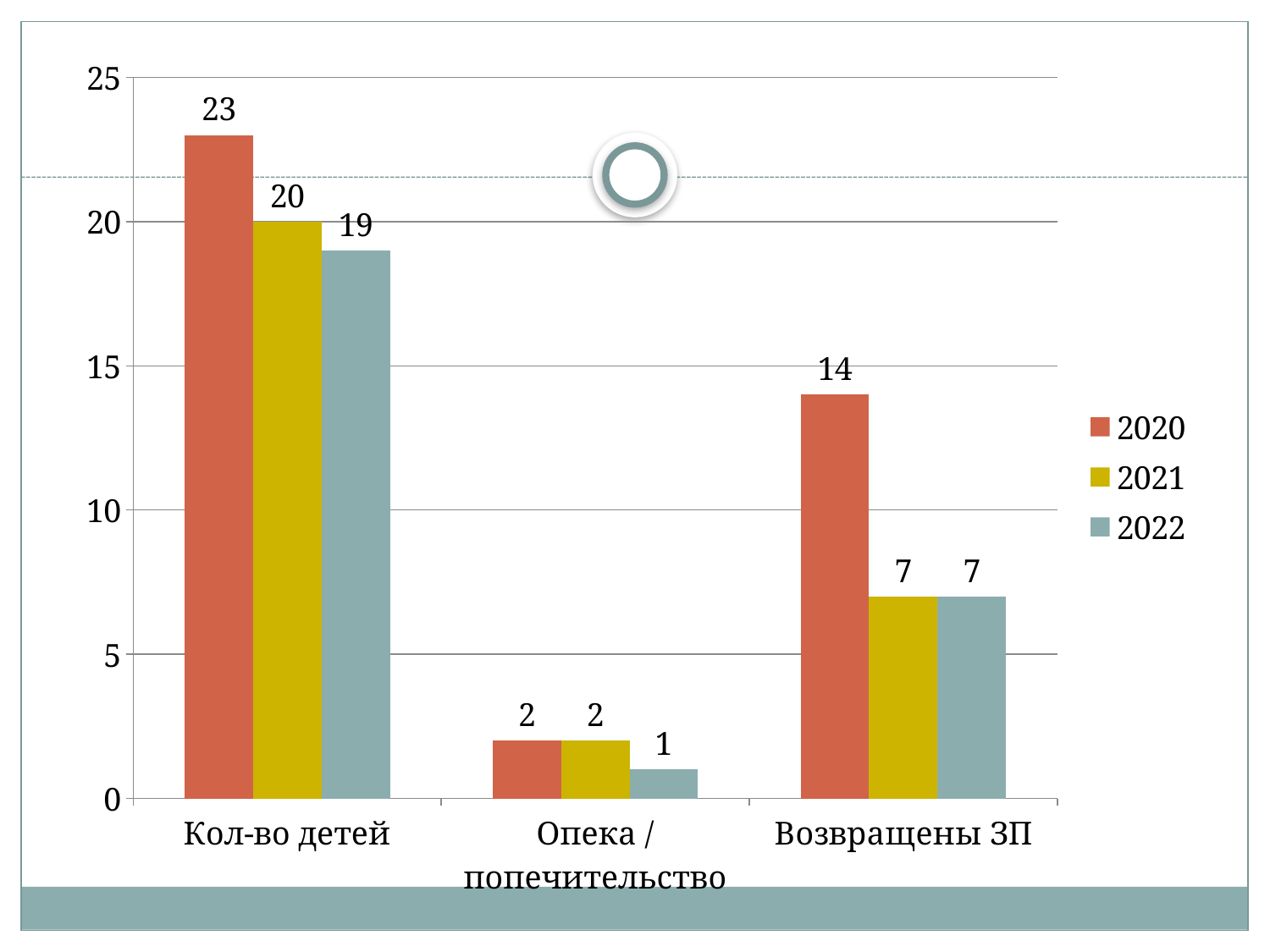
How many series does the legend list? 3 What is the difference between the 2020 and 2021 values in the Возвращены ЗП category? 7 Is the value for 2020 in the Возвращены ЗП category greater or less than 10? greater What kind of chart is shown on the slide? bar chart What is the difference between the 2020 and 2022 values in the Кол-во детей category? 4 Which is larger in the Кол-во детей category: the 2021 value or the 2022 value? 2021 What is the value for 2020 in the Кол-во детей category? 23 How many categories are shown on the x axis? 3 What is the value for 2021 in the Возвращены ЗП category? 7 Which category has the highest value for the 2020 series? Кол-во детей What is the value for 2022 in the Опека / попечительство category? 1 Which category has the lowest value for the 2022 series? Опека / попечительство